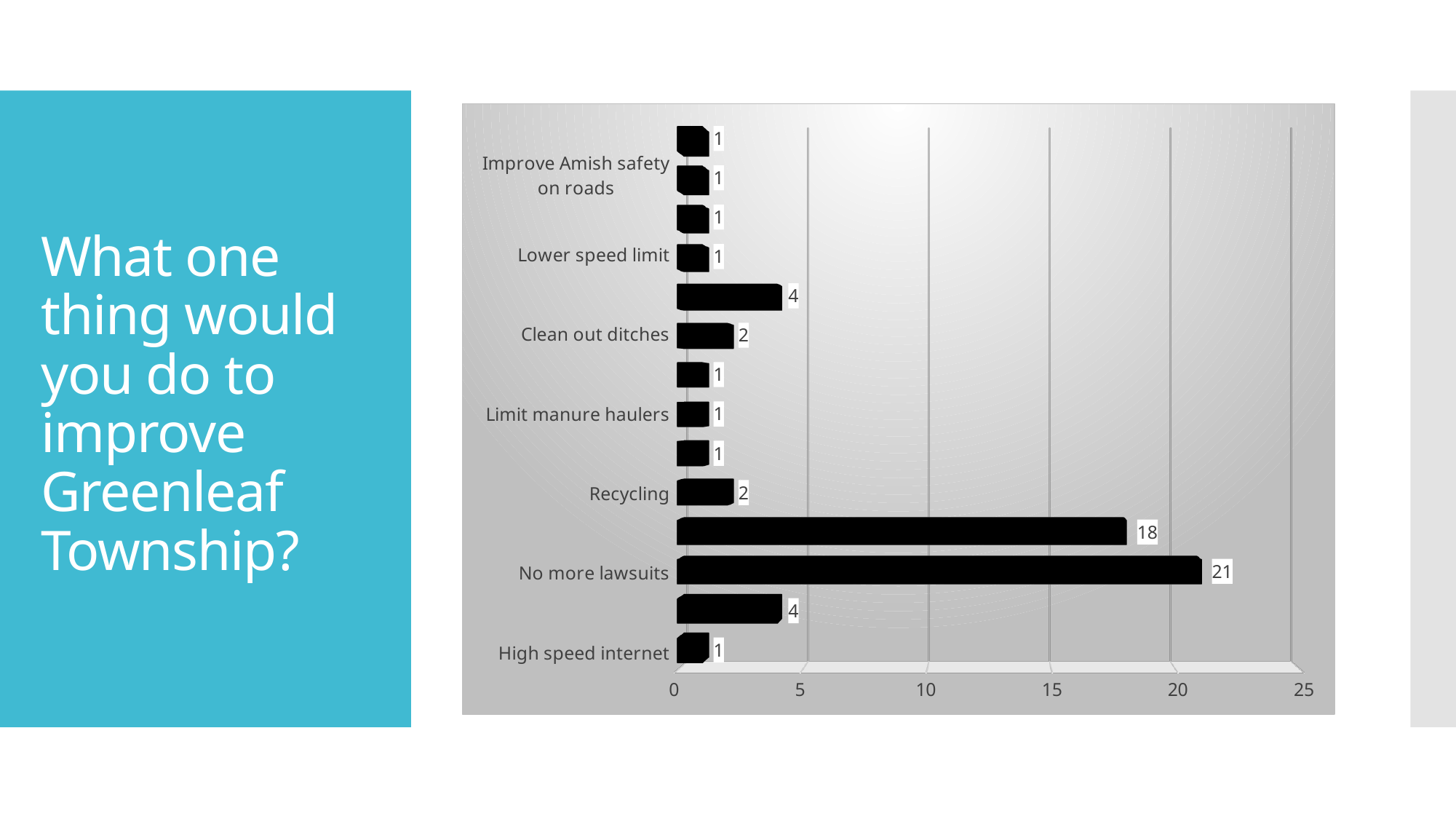
What kind of chart is shown on the slide? Bar chart What value is shown for Recycling? 2 What is the highest value shown on the horizontal axis? 25 Which has the larger value, Clean out ditches or Lower speed limit? Clean out ditches What is the difference between the values for No more lawsuits and Recycling? 19 What value is shown for No more lawsuits? 21 Which labelled category has the highest value? No more lawsuits How many bars are plotted in the chart? 14 What value is shown for Clean out ditches? 2 What value is shown for Limit manure haulers? 1 Is the value for No more lawsuits greater or less than 20? greater What value is shown for High speed internet? 1